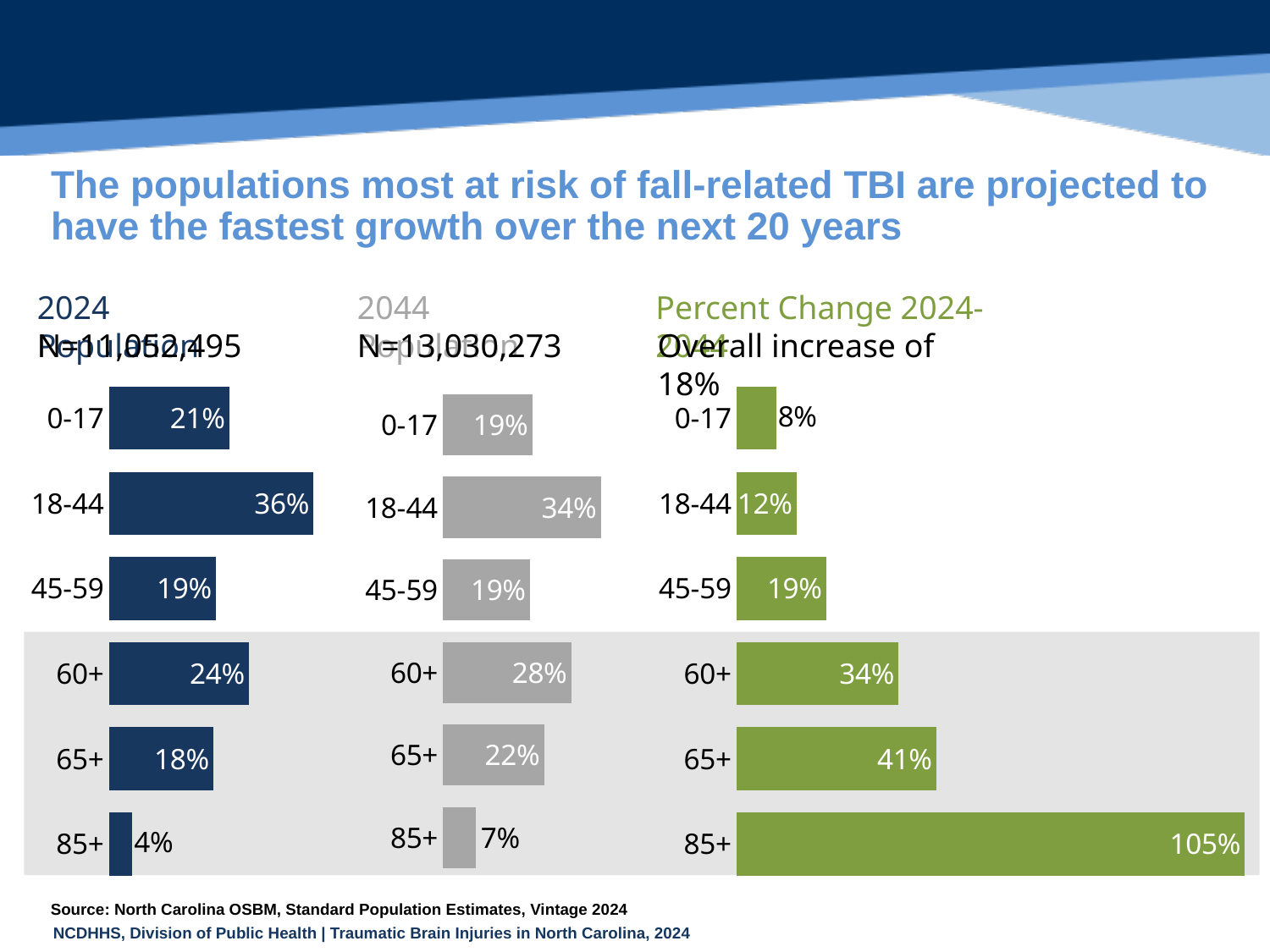
How many age groups are shown in the 2044 chart in the middle? 6 In the 2024 chart on the left, which is larger, the value for 60+ or the value for 0-17? 60+ In the Percent Change 2024-2044 chart on the right, what is the difference between the values for 85+ and 65+? 64% In the 2024 chart on the left, what is the value for the 18-44 age group? 36% What kind of chart is the Percent Change 2024-2044 chart on the right? Bar chart What colour are the bars in the 2044 chart in the middle? Grey In the Percent Change 2024-2044 chart on the right, what is the value for the 65+ age group? 41% In the Percent Change 2024-2044 chart on the right, which age group has the highest value? 85+ In the 2044 chart in the middle, which age group has the highest value? 18-44 In the 2024 chart on the left, which age group has the lowest value? 85+ In the 2044 chart in the middle, what is the value for the 60+ age group? 28% In the Percent Change 2024-2044 chart on the right, do the values rise or fall going from the 0-17 group down to the 85+ group? Rise